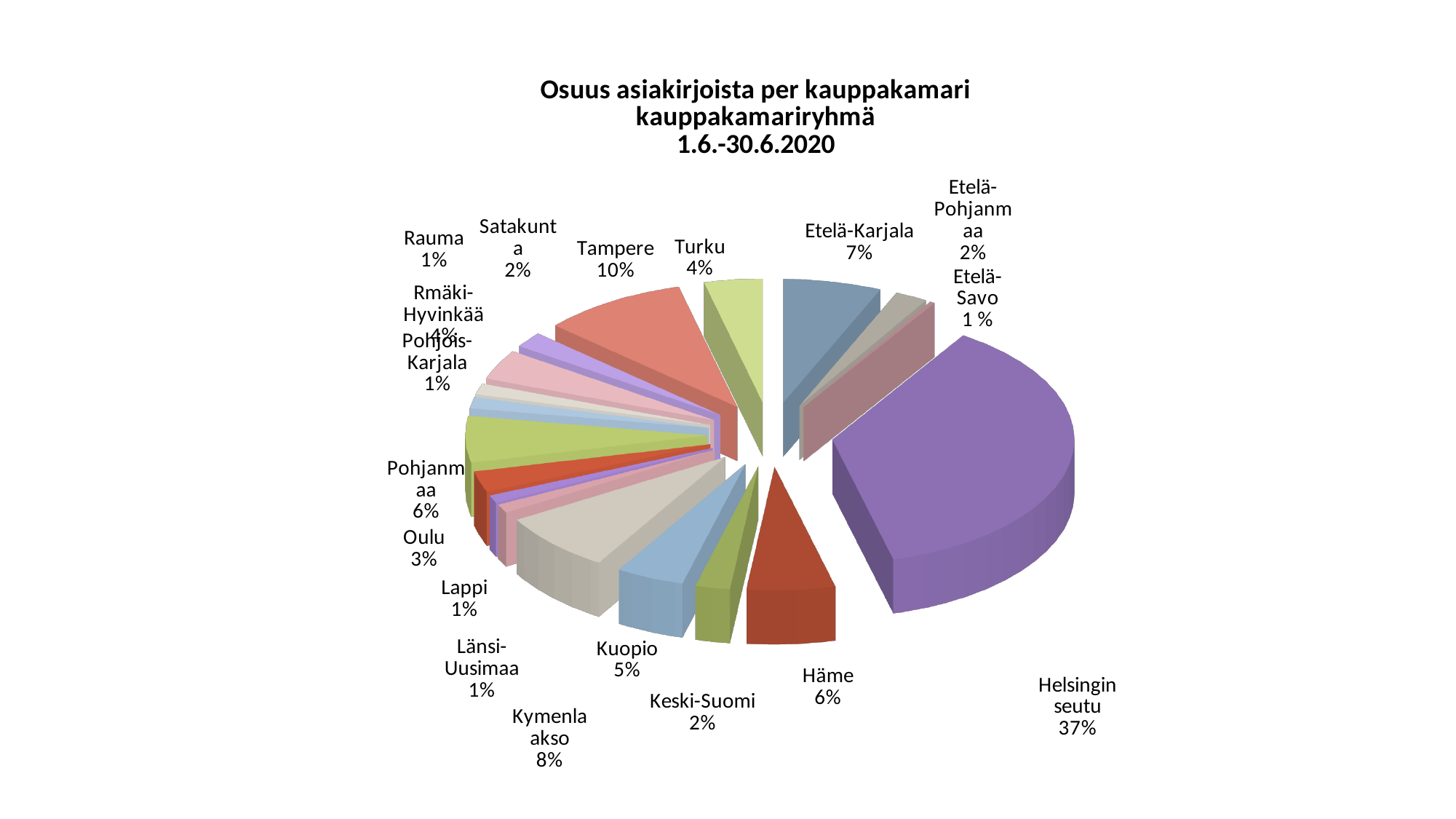
Which has a larger share, Oulu or Pohjanmaa? Pohjanmaa What share of the pie does Helsingin seutu have? 37% Which category has the largest slice of the pie? Helsingin seutu What is the difference between the shares of Helsingin seutu and Tampere? 27% What is the difference between the shares of Kymenlaakso and Häme? 2% Which has a larger share, Tampere or Kymenlaakso? Tampere What is the value shown for Kymenlaakso? 8% What is the value shown for Etelä-Karjala? 7% How many categories are shown in the pie chart? 18 What is the value shown for Kuopio? 5% What kind of chart is shown on the slide? Pie chart What is the value shown for Tampere? 10%